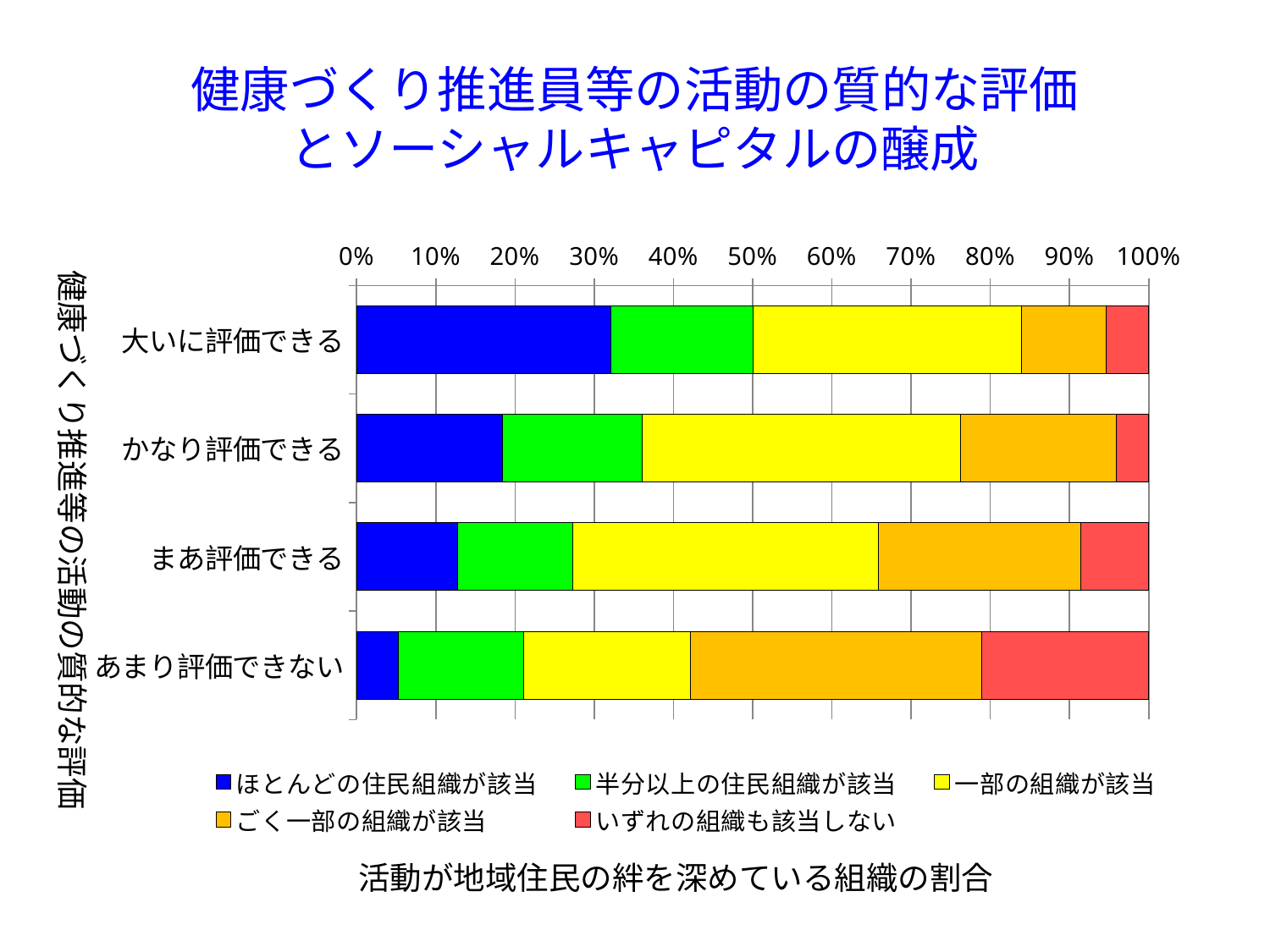
What does each stacked bar total on the horizontal axis? 100% Is the blue (ほとんどの住民組織が該当) value for あまり評価できない greater or less than 10%? less Is the red (いずれの組織も該当しない) value for あまり評価できない greater or less than 10%? greater How many series does the legend list? 5 Is the blue (ほとんどの住民組織が該当) value for 大いに評価できる greater or less than 20%? greater What kind of chart is shown on the slide? Stacked bar chart Which category has the smallest blue (ほとんどの住民組織が該当) segment? あまり評価できない Which category has the largest red (いずれの組織も該当しない) segment? あまり評価できない What is the title of the horizontal axis of the chart? 活動が地域住民の絆を深めている組織の割合 Which category has the largest blue (ほとんどの住民組織が該当) segment? 大いに評価できる How many categories are shown on the vertical axis of the chart? 4 Which is larger: the blue (ほとんどの住民組織が該当) segment for 大いに評価できる or for まあ評価できる? 大いに評価できる